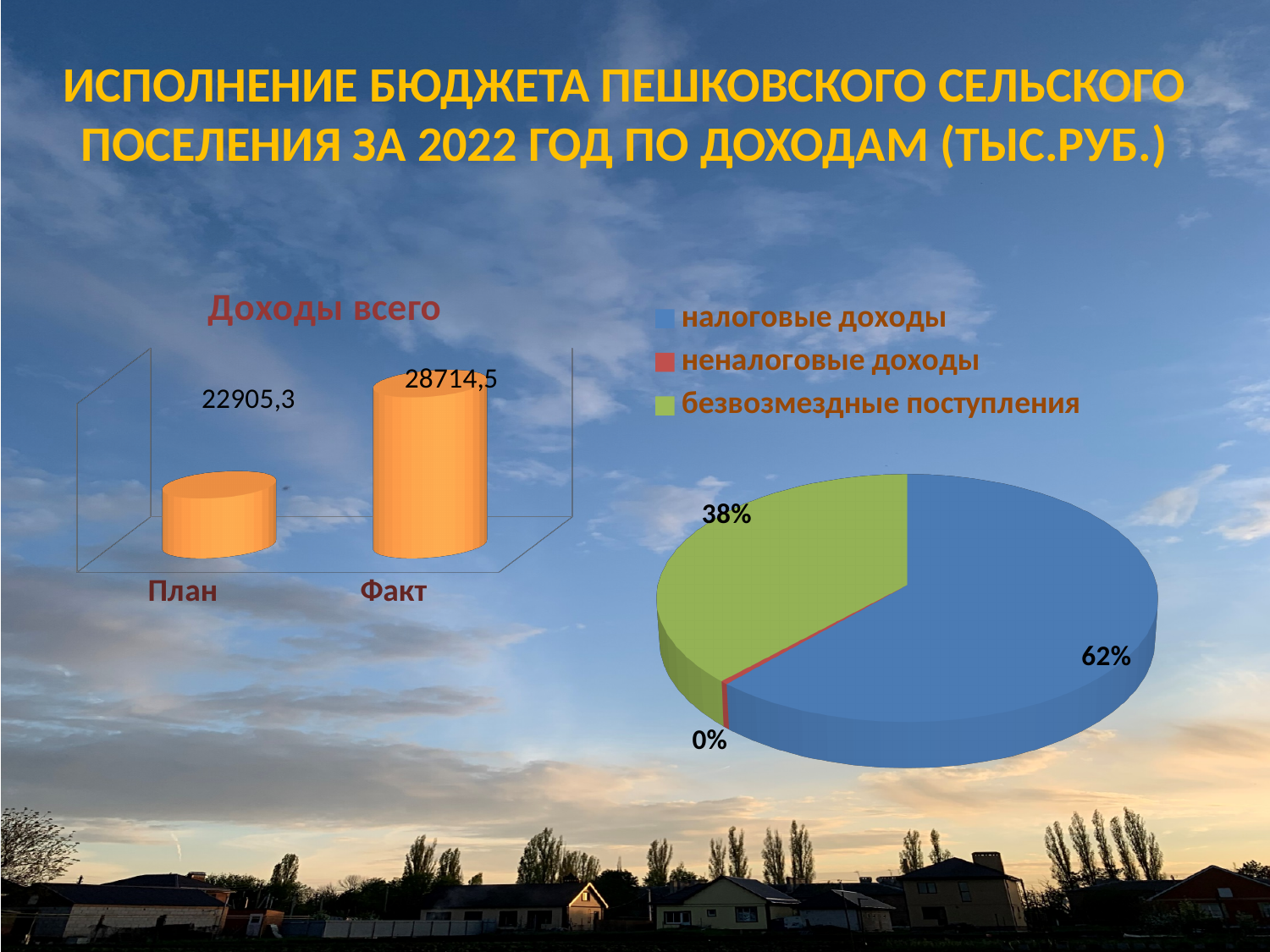
In the pie chart on the right, what share is неналоговые доходы? 0% In the 'Доходы всего' chart, what is the value for Факт? 28714,5 In the pie chart on the right, how many entries does the legend list? 3 What kind of chart is the 'Доходы всего' chart on the left? Bar chart In the 'Доходы всего' chart, what is the value for План? 22905,3 In the pie chart on the right, what share is безвозмездные поступления? 38% In the pie chart on the right, what colour is the безвозмездные поступления slice? Green In the pie chart on the right, which category has the largest share? налоговые доходы In the pie chart on the right, what share is налоговые доходы? 62% In the 'Доходы всего' chart, which category has the higher value, План or Факт? Факт In the 'Доходы всего' chart, how many categories are shown? 2 In the 'Доходы всего' chart, what is the difference between Факт and План? 5809,2